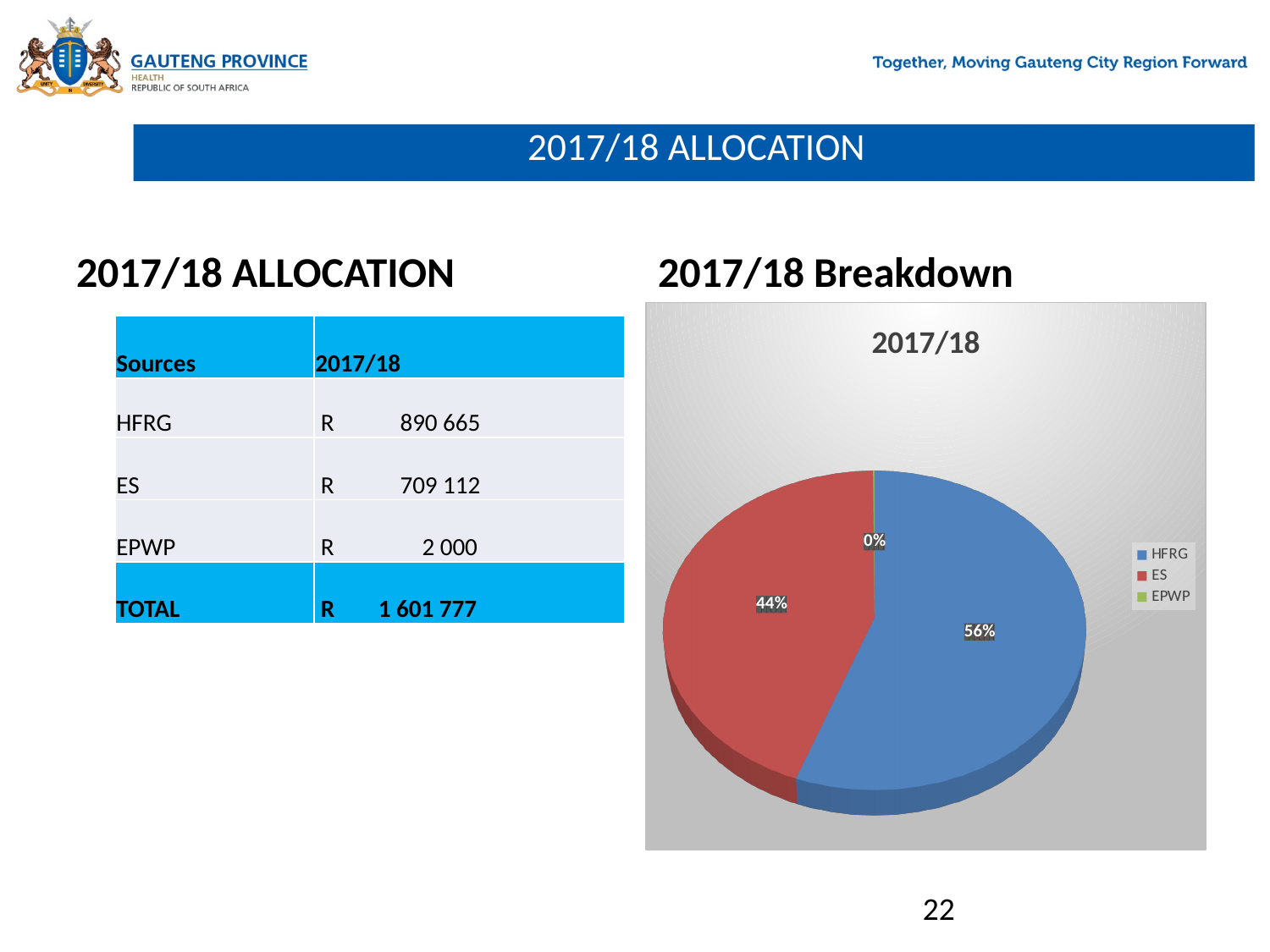
How many entries does the pie chart's legend list? 3 What kind of chart is shown on the slide? pie chart What is the title of the pie chart? 2017/18 How many slices are shown in the pie chart? 3 What is the difference in percentage points between the HFRG and ES slices in the pie chart? 12% Which category has the smallest slice in the pie chart? EPWP In the pie chart, which slice is larger, HFRG or ES? HFRG Which category has the largest slice in the pie chart? HFRG What percentage share does the HFRG slice have in the pie chart? 56% What percentage share does the ES slice have in the pie chart? 44% What percentage share does the EPWP slice have in the pie chart? 0% What colour is the ES slice in the pie chart? red